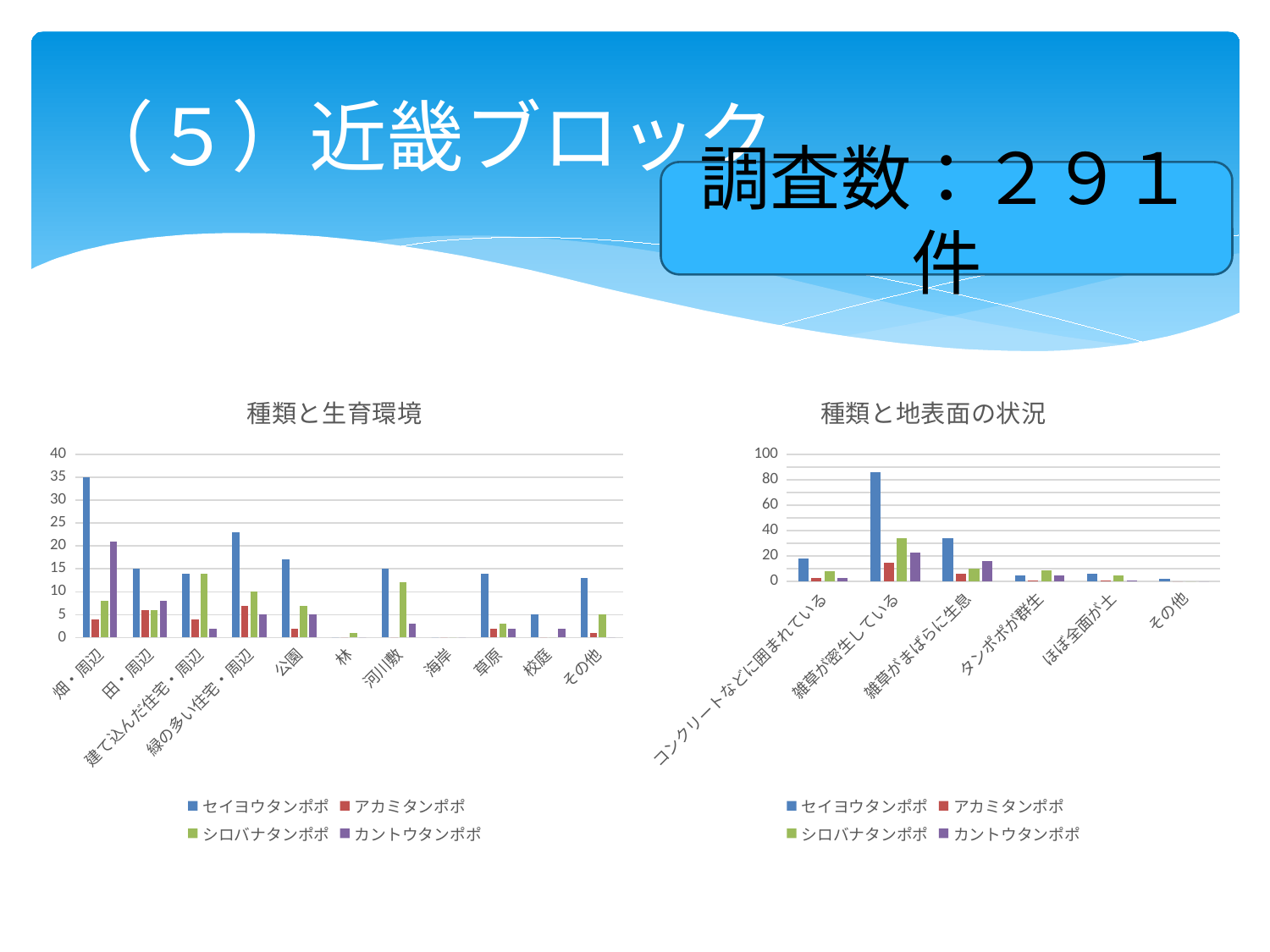
In the chart titled 種類と生育環境, is the value for セイヨウタンポポ at 畑・周辺 greater or less than 30? greater In the chart titled 種類と生育環境, which is larger at 河川敷: セイヨウタンポポ or シロバナタンポポ? セイヨウタンポポ How many categories are shown on the x axis of the chart titled 種類と地表面の状況? 6 What is the title of the chart on the right side of the slide? 種類と地表面の状況 In the chart titled 種類と生育環境, is the value for カントウタンポポ at 畑・周辺 greater or less than 15? greater How many categories are shown on the x axis of the chart titled 種類と生育環境? 11 In the chart titled 種類と地表面の状況, which is larger at 雑草が密生している: シロバナタンポポ or アカミタンポポ? シロバナタンポポ How many series does the legend of the chart titled 種類と地表面の状況 list? 4 In the chart titled 種類と地表面の状況, is the value for セイヨウタンポポ at 雑草が密生している greater or less than 80? greater What kind of chart is the chart titled 種類と生育環境? bar chart In the chart titled 種類と生育環境, which category has the highest value for セイヨウタンポポ? 畑・周辺 In the chart titled 種類と地表面の状況, which category has the highest value for セイヨウタンポポ? 雑草が密生している